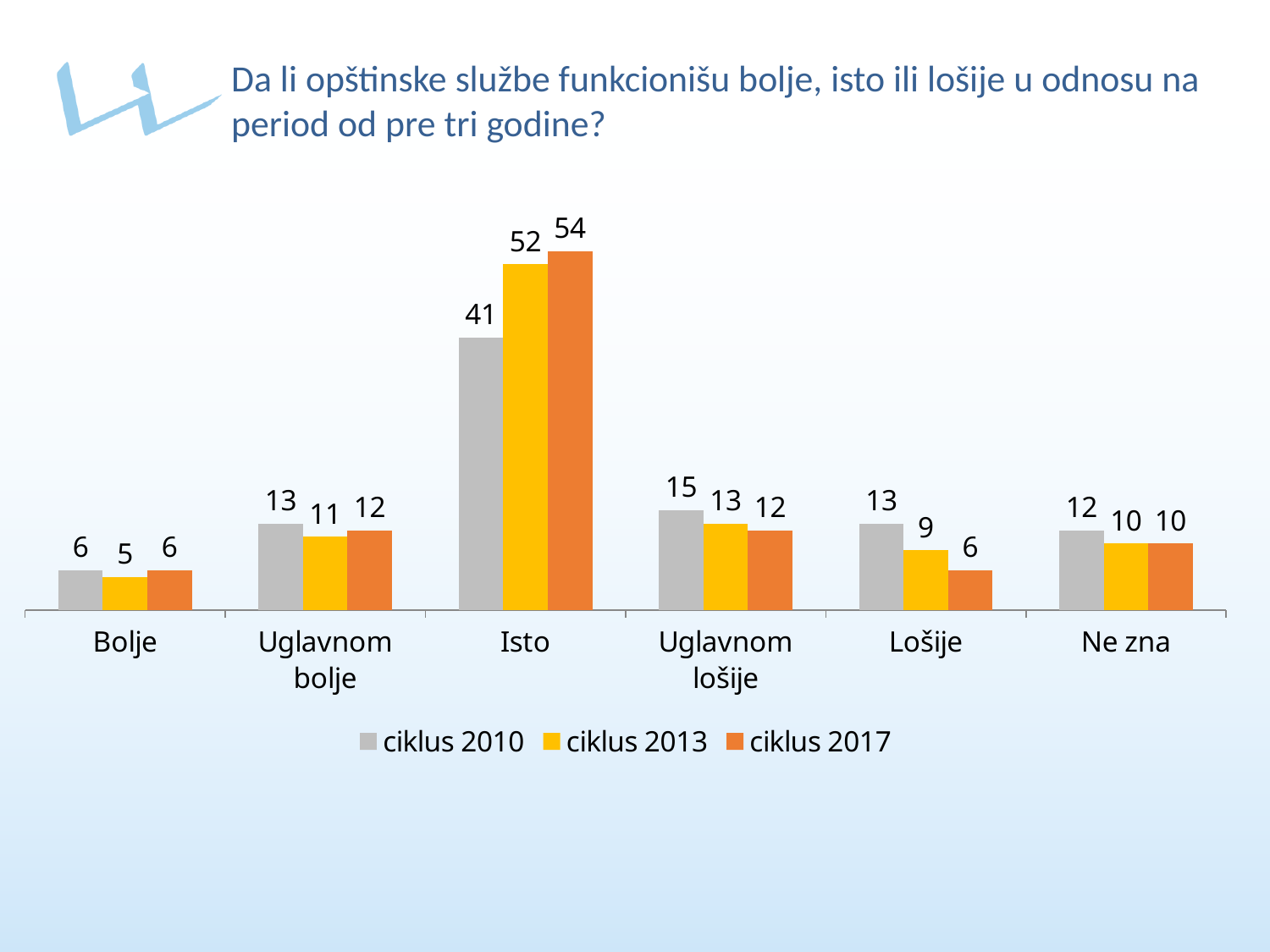
What kind of chart is shown on the slide? bar chart Which is larger for Uglavnom bolje: the ciklus 2010 value or the ciklus 2013 value? ciklus 2010 Which category has the lowest value in the ciklus 2013 series? Bolje What is the value for Lošije in the ciklus 2013 series? 9 What is the difference between the ciklus 2010 and ciklus 2017 values for Lošije? 7 How many categories are shown on the x axis? 6 What is the difference between the ciklus 2017 and ciklus 2010 values for Isto? 13 How many series does the legend list? 3 Which category has the highest value in the ciklus 2010 series? Isto Which colour represents the ciklus 2013 series? yellow What is the value for Uglavnom lošije in the ciklus 2010 series? 15 What is the value for Isto in the ciklus 2017 series? 54